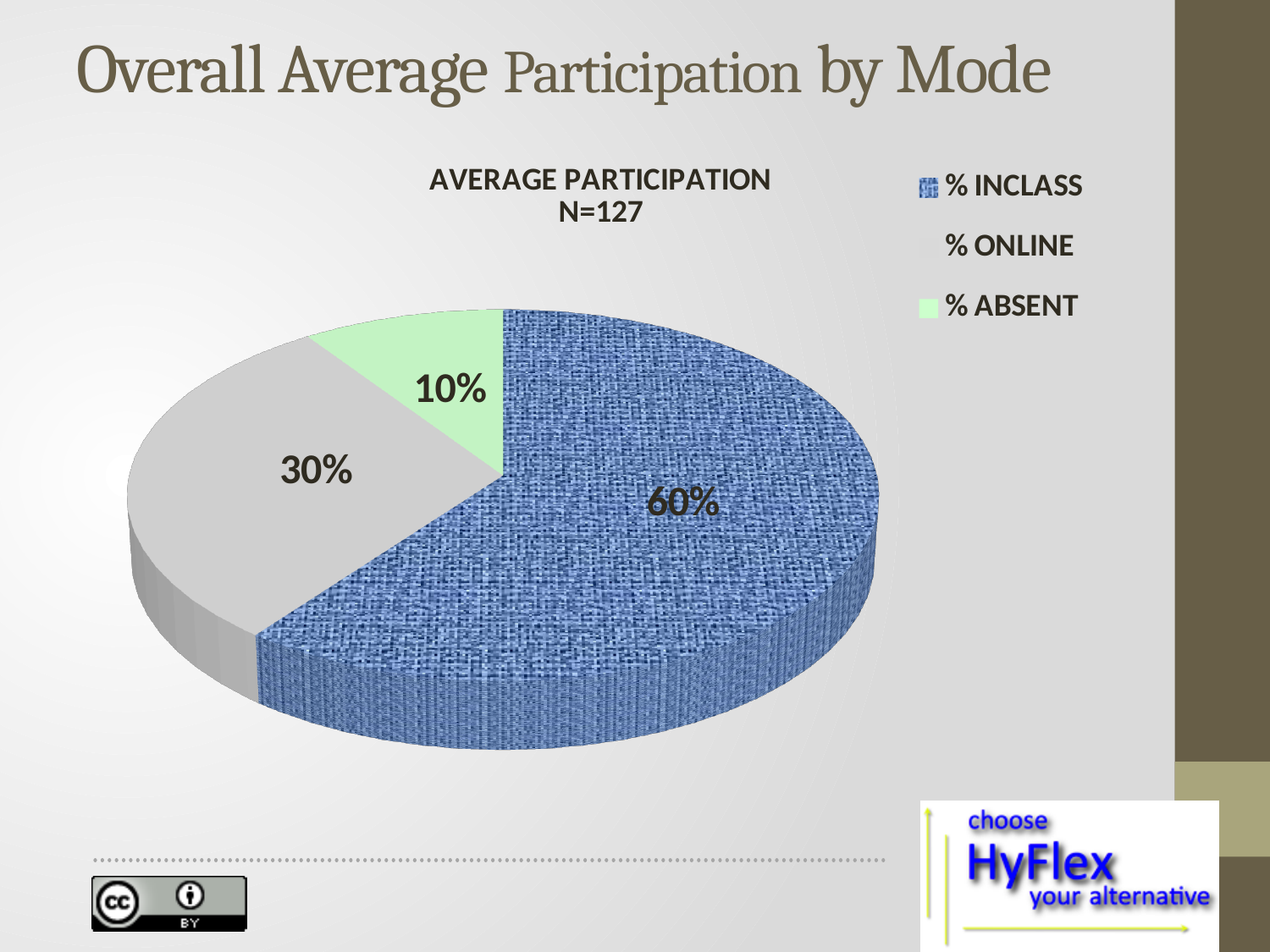
Which category has the smallest share of the pie? % ABSENT Which is larger, the % ONLINE share or the % ABSENT share? % ONLINE What is the difference between the % INCLASS and % ONLINE shares? 30% What is the chart's title? AVERAGE PARTICIPATION N=127 What percentage is shown for % INCLASS? 60% What colour is the % ABSENT slice? Light green What type of chart is shown on the slide? Pie chart What percentage is shown for % ABSENT? 10% What percentage is shown for % ONLINE? 30% How many slices does the pie chart have? 3 Which category has the largest share of the pie? % INCLASS How many entries does the legend list? 3